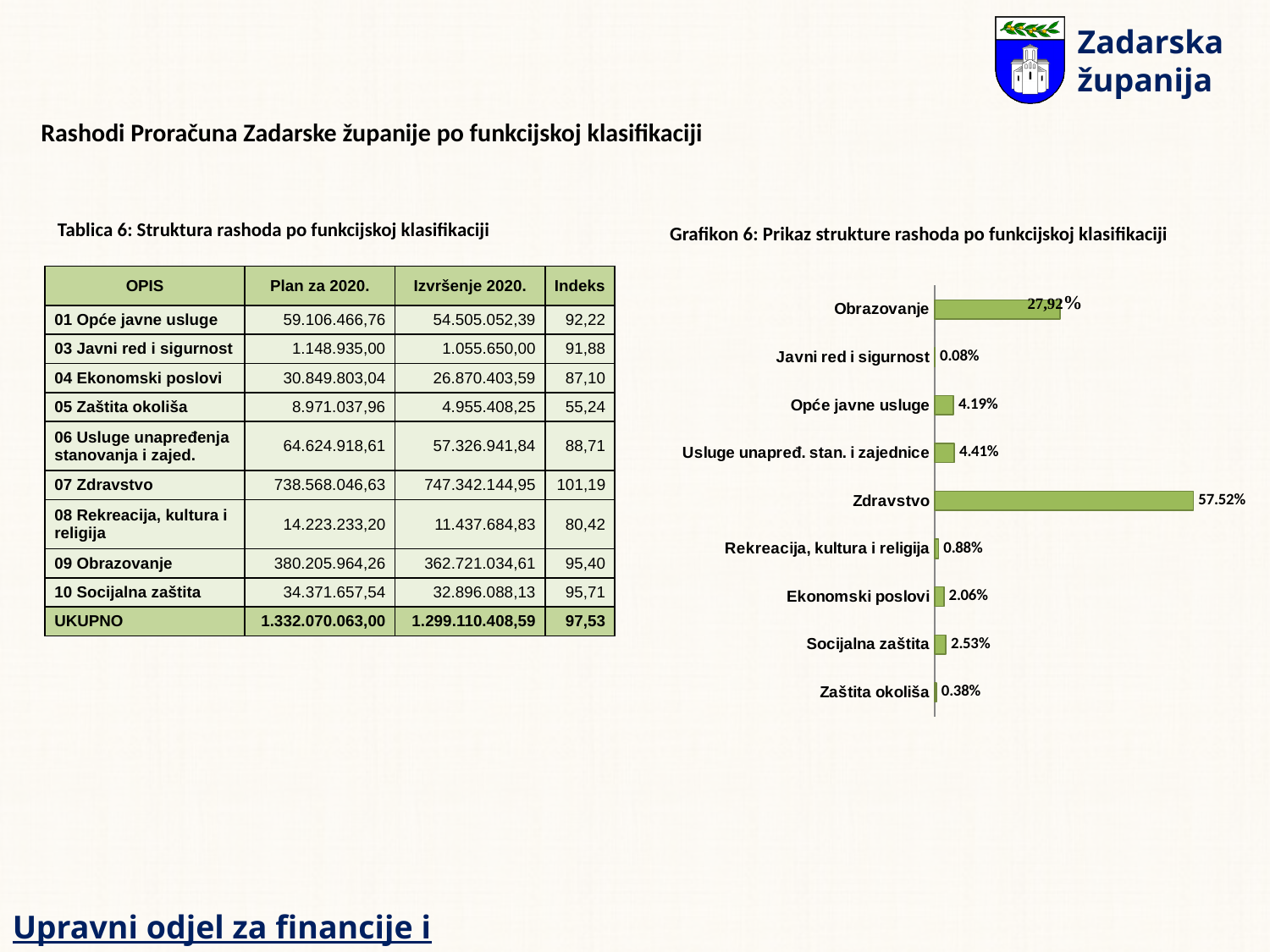
What kind of chart is Grafikon 6? bar chart How many categories are shown in Grafikon 6? 9 In Grafikon 6, what is the share for Zaštita okoliša? 0.38% In Grafikon 6, which category has the highest share? Zdravstvo In Grafikon 6, what is the share for Zdravstvo? 57.52% In Grafikon 6, what is the share for Socijalna zaštita? 2.53% In Grafikon 6, what is the difference between the shares of Usluge unapređ. stan. i zajednice and Opće javne usluge? 0.22% In Grafikon 6, what is the difference between the shares of Socijalna zaštita and Ekonomski poslovi? 0.47% In Grafikon 6, what is the share for Obrazovanje? 27,92% In Grafikon 6, which has the larger share, Zdravstvo or Obrazovanje? Zdravstvo In Grafikon 6, which category has the lowest share? Javni red i sigurnost In Grafikon 6, what is the share for Usluge unapređ. stan. i zajednice? 4.41%